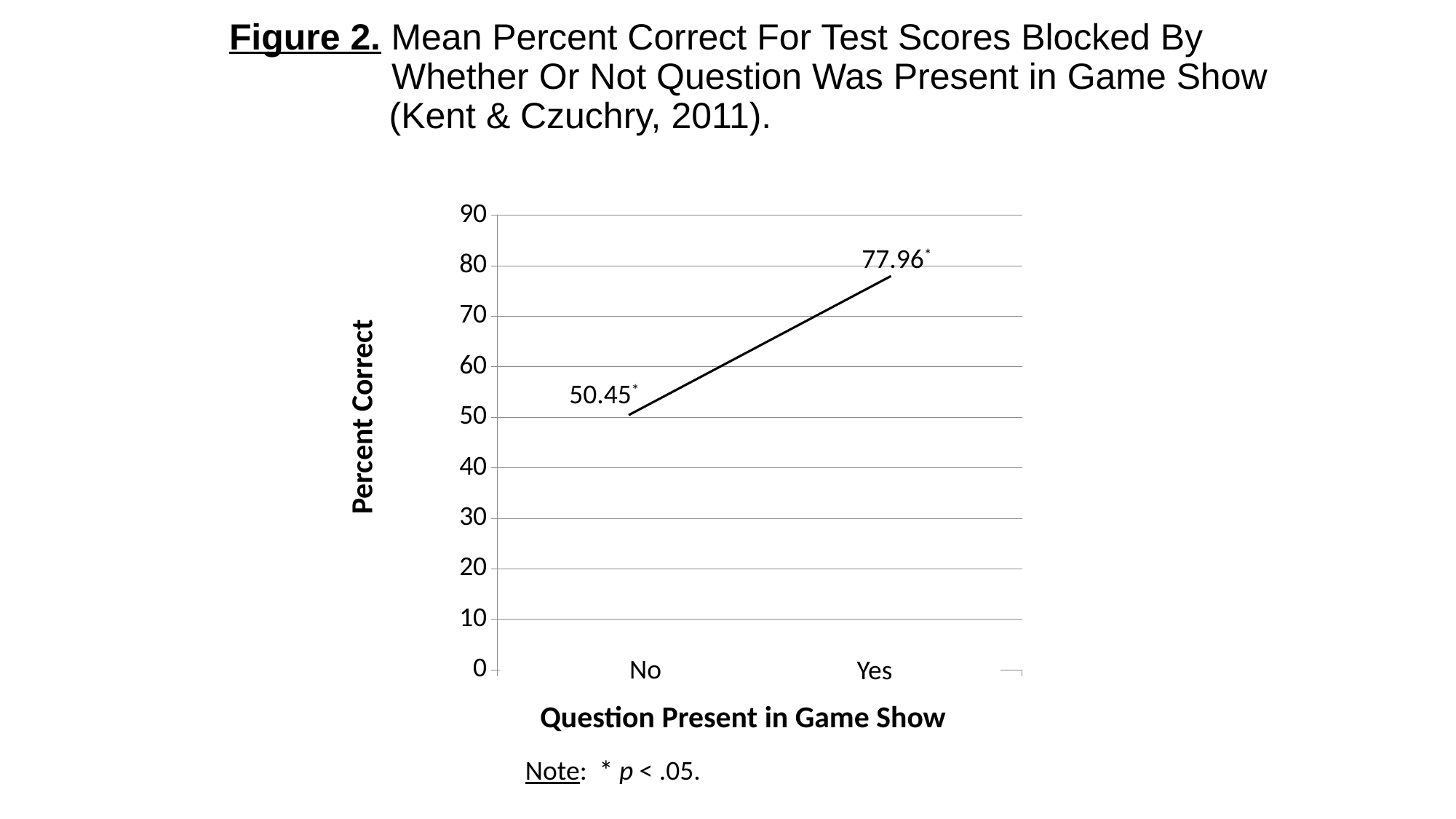
How many categories are shown on the x axis? 2 Is the percent correct for No greater or less than 60? less Which category has the higher percent correct, No or Yes? Yes Does the percent correct rise or fall from No to Yes? rise What kind of chart is shown on the slide? line chart What is the mean percent correct when the question was not present in the game show (No)? 50.45 What is the mean percent correct when the question was present in the game show (Yes)? 77.96 What is the label of the y axis? Percent Correct Which category has the lower percent correct? No Is the percent correct for Yes greater or less than 70? greater What is the difference in percent correct between Yes and No? 27.51 What is the label of the x axis? Question Present in Game Show